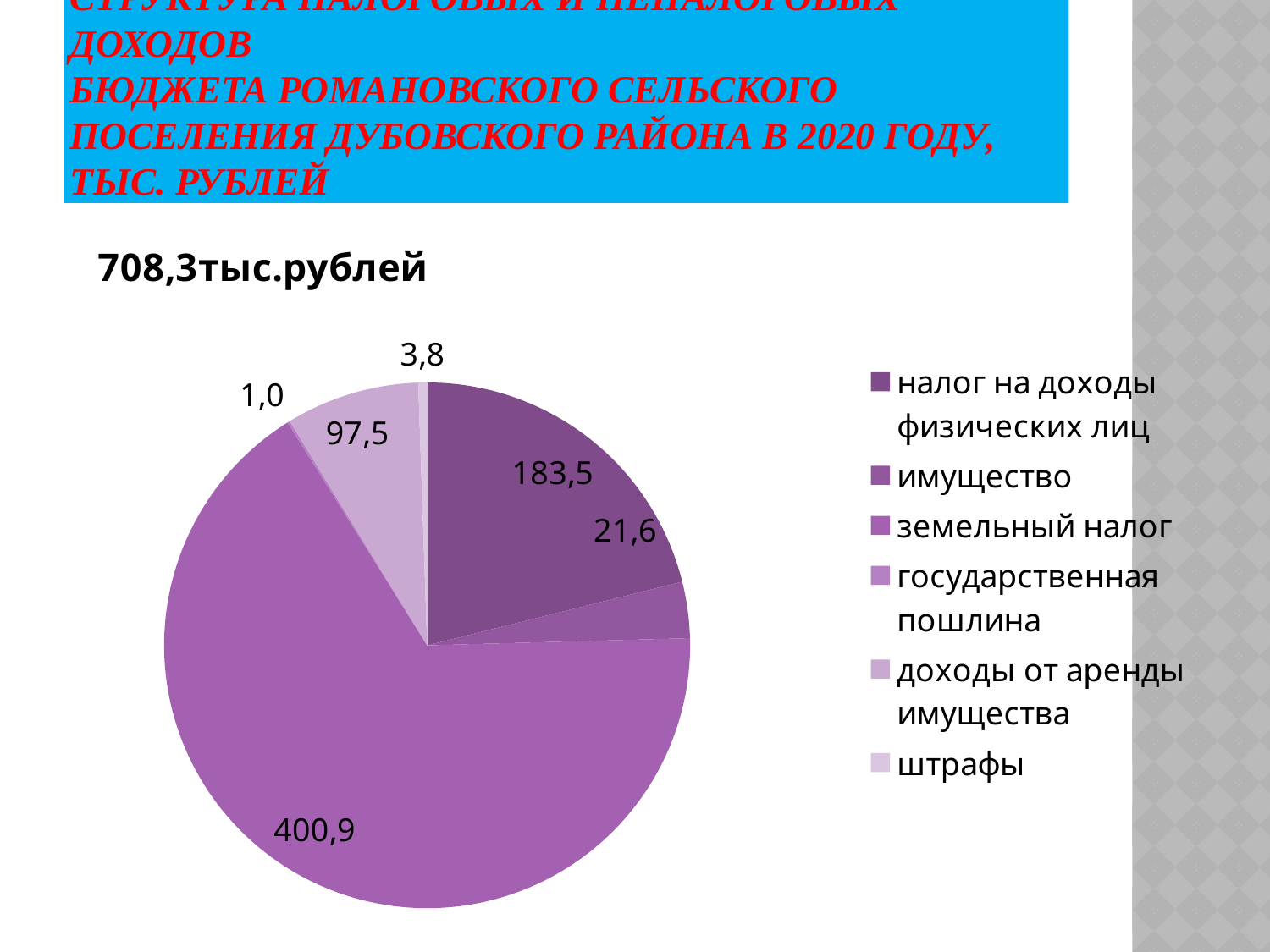
How many categories does the legend list? 6 What type of chart is shown on the slide? pie chart What is the value for земельный налог? 400,9 What is the difference between the values for земельный налог and налог на доходы физических лиц? 217,4 Which category has the largest slice of the pie? земельный налог What is the value for имущество? 21,6 What is the value for государственная пошлина? 1,0 What is the value for налог на доходы физических лиц? 183,5 Which is larger, the value for государственная пошлина or the value for имущество? имущество What total amount in thousand rubles is stated above the pie chart? 708,3тыс.рублей What is the value for штрафы? 3,8 Which category has the smallest slice of the pie? государственная пошлина